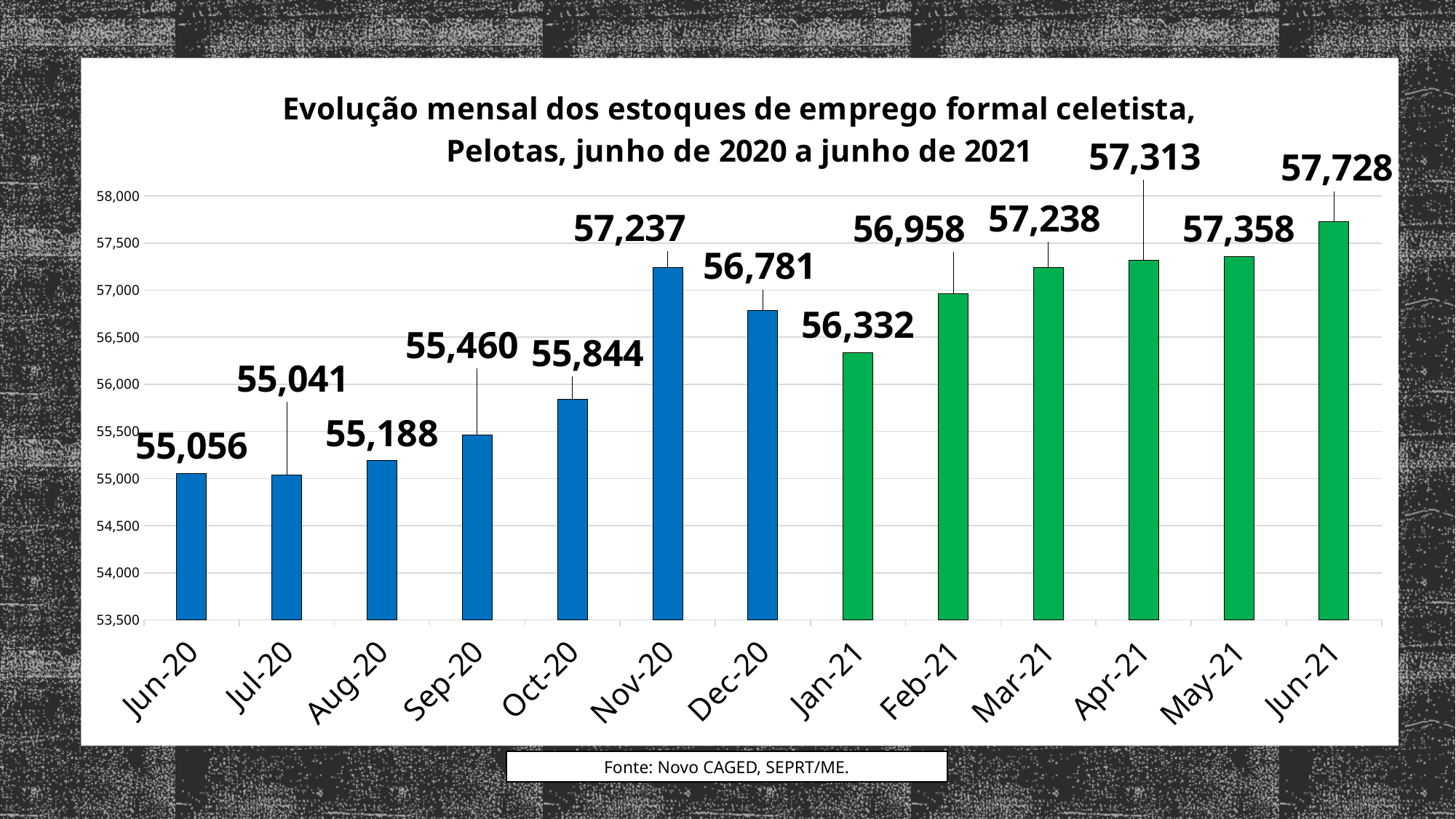
What is the value for Aug-20? 55,188 Which month has the lowest value? Jul-20 What is the value for Nov-20? 57,237 What colour are the bars for the 2021 months? green Which month has the highest value? Jun-21 How many months are shown on the x axis? 13 What kind of chart is shown on the slide? bar chart What is the difference between the values for Nov-20 and Dec-20? 456 What is the difference between the values for Jun-21 and Jun-20? 2,672 Which is larger, the value for Oct-20 or the value for Jan-21? Jan-21 Is the value for Sep-20 greater or less than 56,000? less What is the value for Jan-21? 56,332